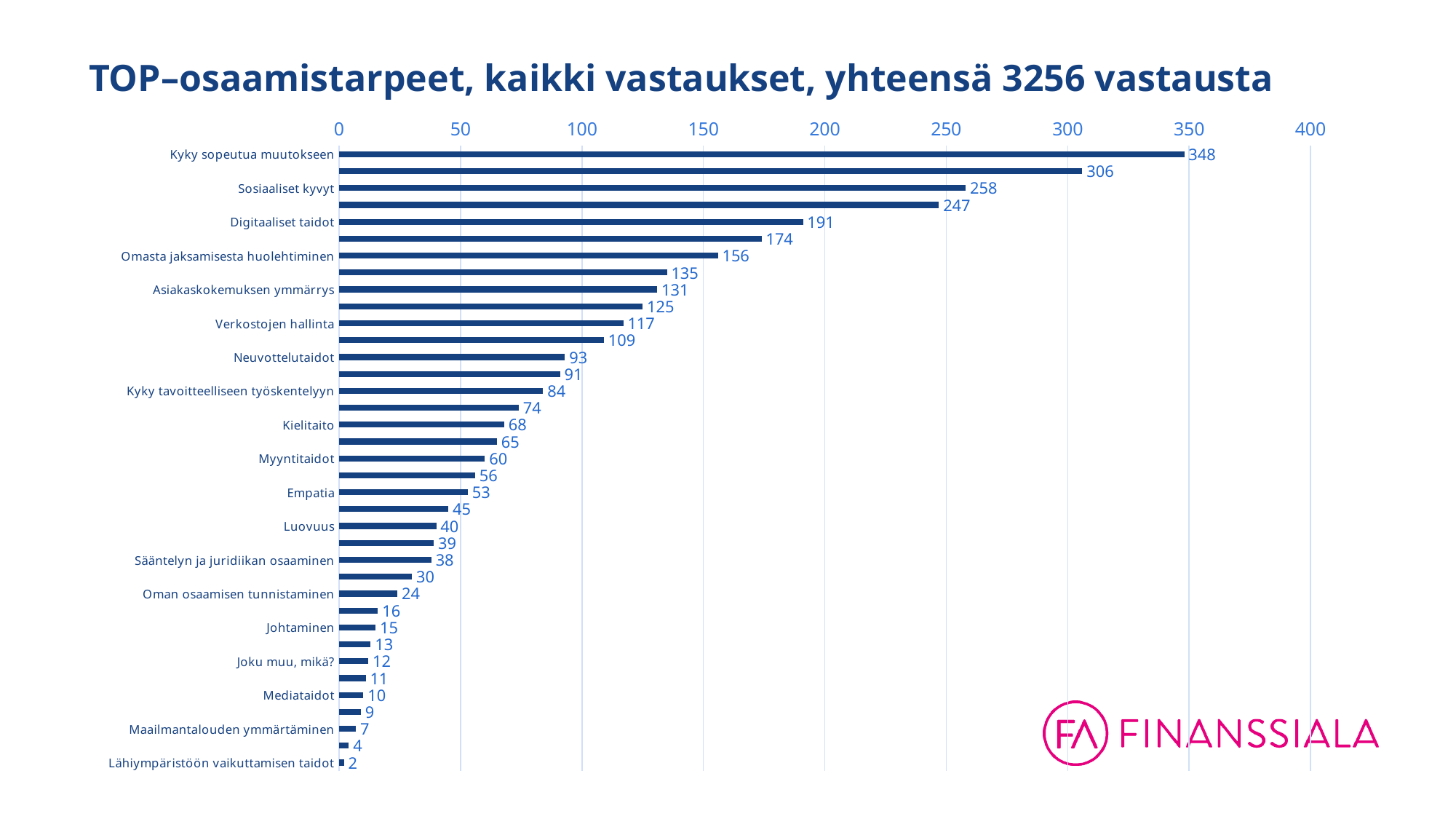
Which category has the highest value? Kyky sopeutua muutokseen What is the value for Mediataidot? 10 Is the value for Omasta jaksamisesta huolehtiminen greater or less than 150? greater Which is larger, the value for Kielitaito or the value for Myyntitaidot? Kielitaito What is the title of the chart? TOP-osaamistarpeet, kaikki vastaukset, yhteensä 3256 vastausta What is the value for Empatia? 53 What is the value for Digitaaliset taidot? 191 What kind of chart is shown on the slide? bar chart What is the value for Neuvottelutaidot? 93 What is the difference between the values for Kyky sopeutua muutokseen and Sosiaaliset kyvyt? 90 What is the value for Kyky sopeutua muutokseen? 348 Which category has the lowest value? Lähiympäristöön vaikuttamisen taidot